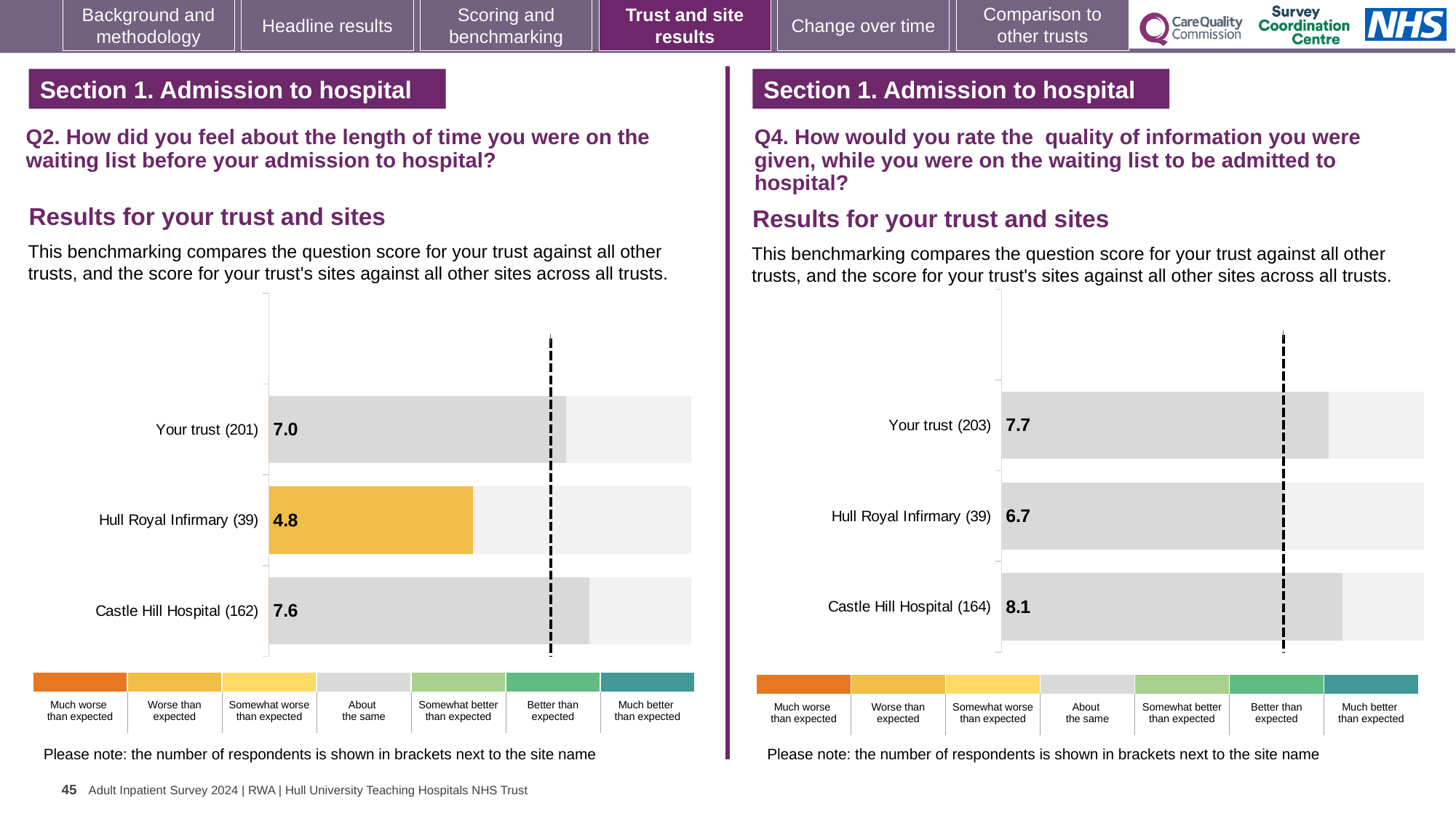
In the Q2 chart on the left, how many respondents are shown in brackets for Castle Hill Hospital? 162 In the Q4 chart on the right, what is the score for Hull Royal Infirmary? 6.7 In the Q2 chart on the left, which site or trust has the lowest score? Hull Royal Infirmary In the Q4 chart on the right, what is the score for Your trust? 7.7 In the Q2 chart on the left, which has the larger score, Your trust or Castle Hill Hospital? Castle Hill Hospital In the Q2 chart on the left, what is the score for Hull Royal Infirmary? 4.8 In the Q2 chart on the left, what is the score for Castle Hill Hospital? 7.6 How many bars are plotted in the Q4 chart on the right? 3 In the Q4 chart on the right, which site or trust has the highest score? Castle Hill Hospital In the Q2 chart on the left, what is the difference between the scores for Castle Hill Hospital and Hull Royal Infirmary? 2.8 What type of chart is used on the left for Q2? Bar chart In the Q4 chart on the right, what is the difference between the scores for Castle Hill Hospital and Your trust? 0.4